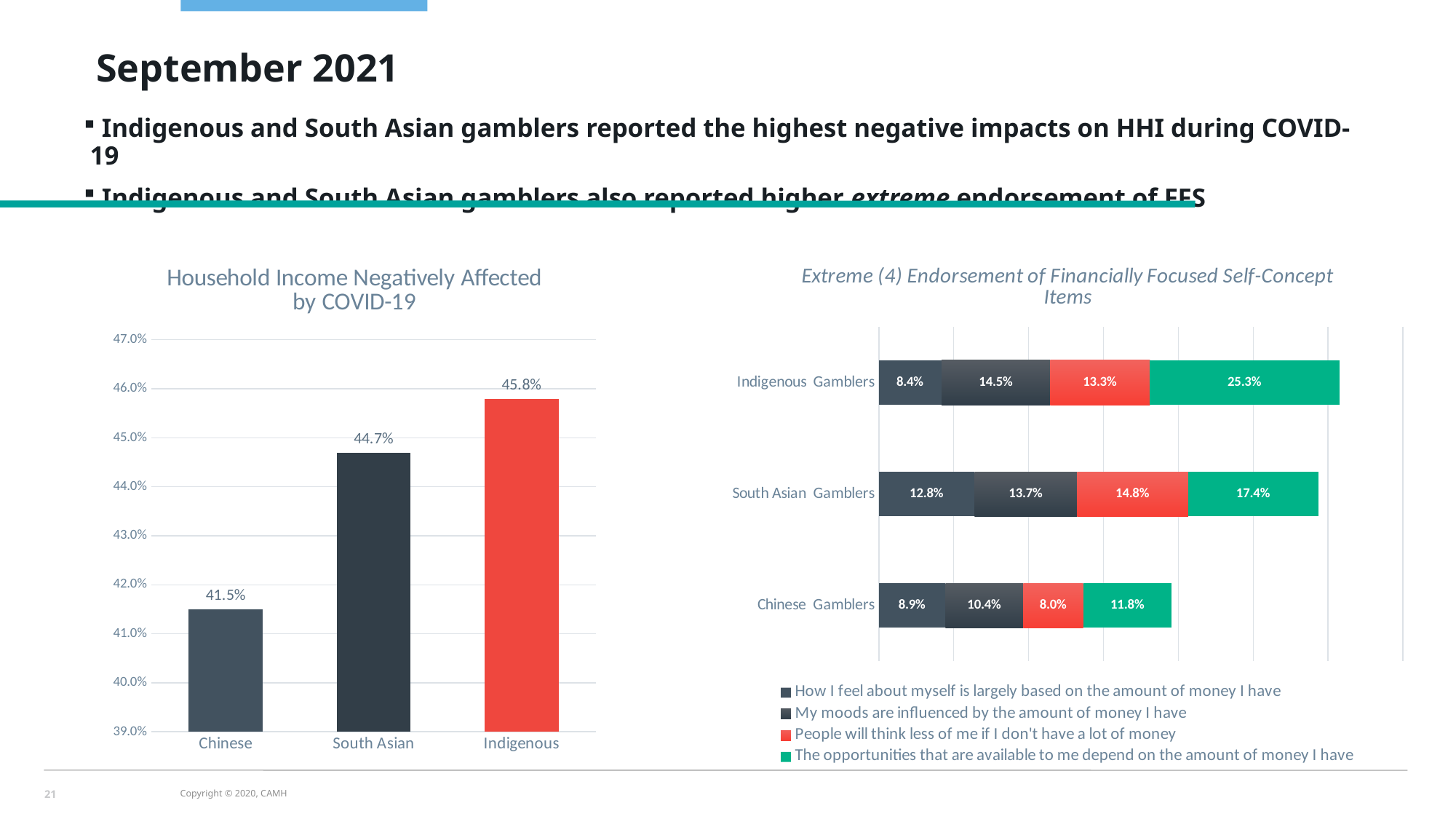
In the 'Household Income Negatively Affected by COVID-19' chart, which category has the highest value? Indigenous What kind of chart is the 'Household Income Negatively Affected by COVID-19' chart? Bar chart In the 'Extreme (4) Endorsement of Financially Focused Self-Concept Items' chart, what is the value for Chinese Gamblers on 'People will think less of me if I don't have a lot of money'? 8.0% In the 'Extreme (4) Endorsement of Financially Focused Self-Concept Items' chart, what is the value for Indigenous Gamblers on 'The opportunities that are available to me depend on the amount of money I have'? 25.3% In the 'Extreme (4) Endorsement of Financially Focused Self-Concept Items' chart, which is larger for 'My moods are influenced by the amount of money I have': Indigenous Gamblers or South Asian Gamblers? Indigenous Gamblers In the 'Household Income Negatively Affected by COVID-19' chart, which category has the lowest value? Chinese In the 'Household Income Negatively Affected by COVID-19' chart, what is the difference between the Indigenous and Chinese values? 4.3 percentage points In the 'Household Income Negatively Affected by COVID-19' chart, how many categories are shown? 3 In the 'Household Income Negatively Affected by COVID-19' chart, what is the value for South Asian? 44.7% In the 'Extreme (4) Endorsement of Financially Focused Self-Concept Items' chart, what is the total of the stacked bar for Chinese Gamblers? 39.1% In the 'Extreme (4) Endorsement of Financially Focused Self-Concept Items' chart, which colour represents 'People will think less of me if I don't have a lot of money'? Red In the 'Extreme (4) Endorsement of Financially Focused Self-Concept Items' chart, how many series does the legend list? 4